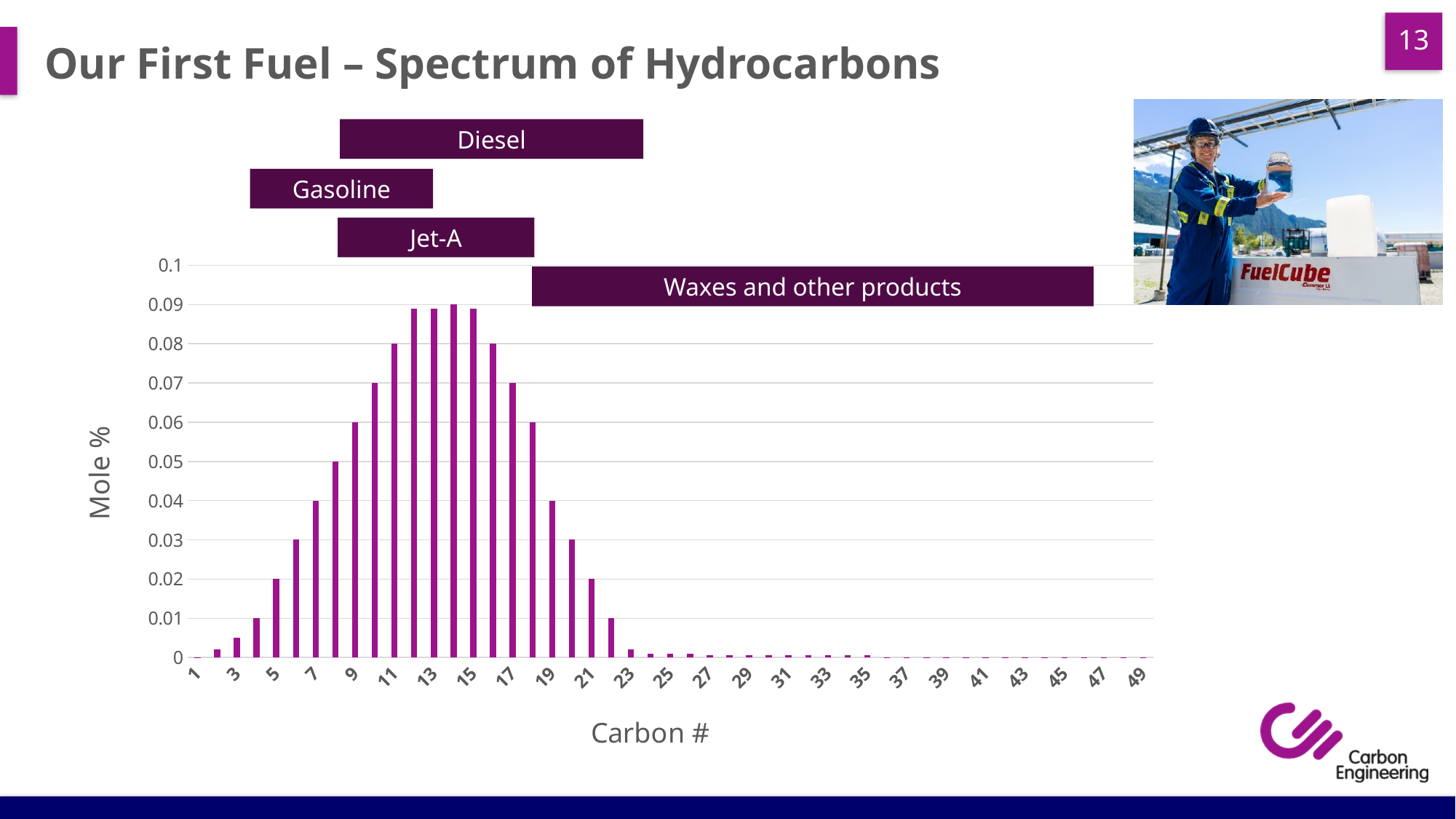
Is the value for carbon number 11 greater or less than 0.05? greater What is the label on the vertical axis of the chart? Mole % Which has the larger Mole % value, carbon number 9 or carbon number 19? carbon number 9 How many product range labels (such as Diesel) are shown above the bars? 4 What is the Mole % value for carbon number 9? 0.06 What is the Mole % value for carbon number 21? 0.02 Which has the larger Mole % value, carbon number 17 or carbon number 21? carbon number 17 What kind of chart is shown on the slide? bar chart Do the values rise or fall as the carbon number increases from 15 to 23? fall Is the value for carbon number 25 greater or less than 0.01? less